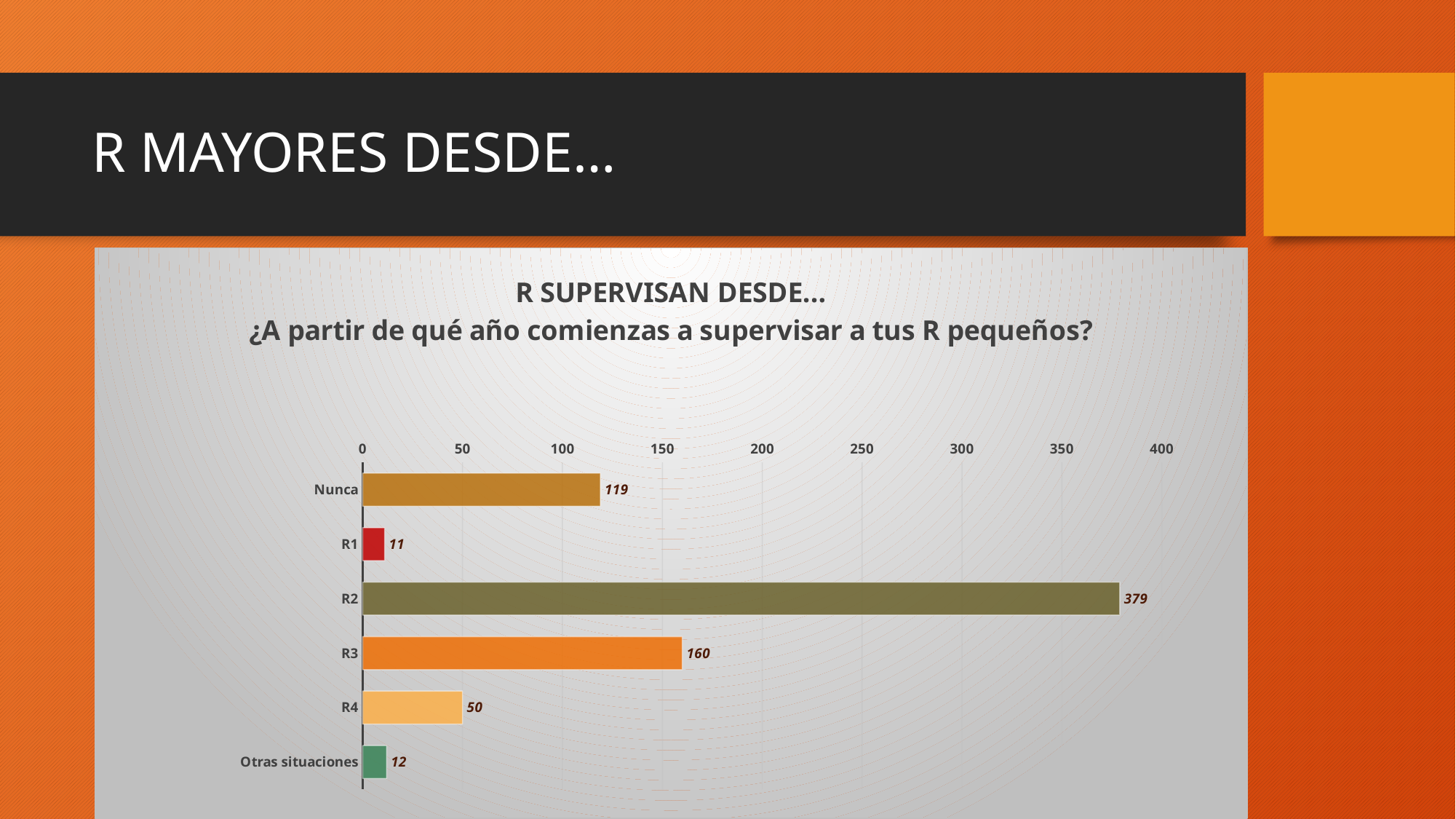
What kind of chart is shown on the slide? bar chart What is the difference between the values for R2 and Nunca? 260 Which is larger, the value for Nunca or the value for R3? R3 What is the title of the chart? R SUPERVISAN DESDE... ¿A partir de qué año comienzas a supervisar a tus R pequeños? Which category has the highest value? R2 How many categories are shown in the chart? 6 What is the value for Nunca? 119 What is the value for Otras situaciones? 12 What is the value for R2? 379 What is the difference between the values for R3 and R4? 110 Is the value for R4 greater or less than 100? less Which category has the lowest value? R1